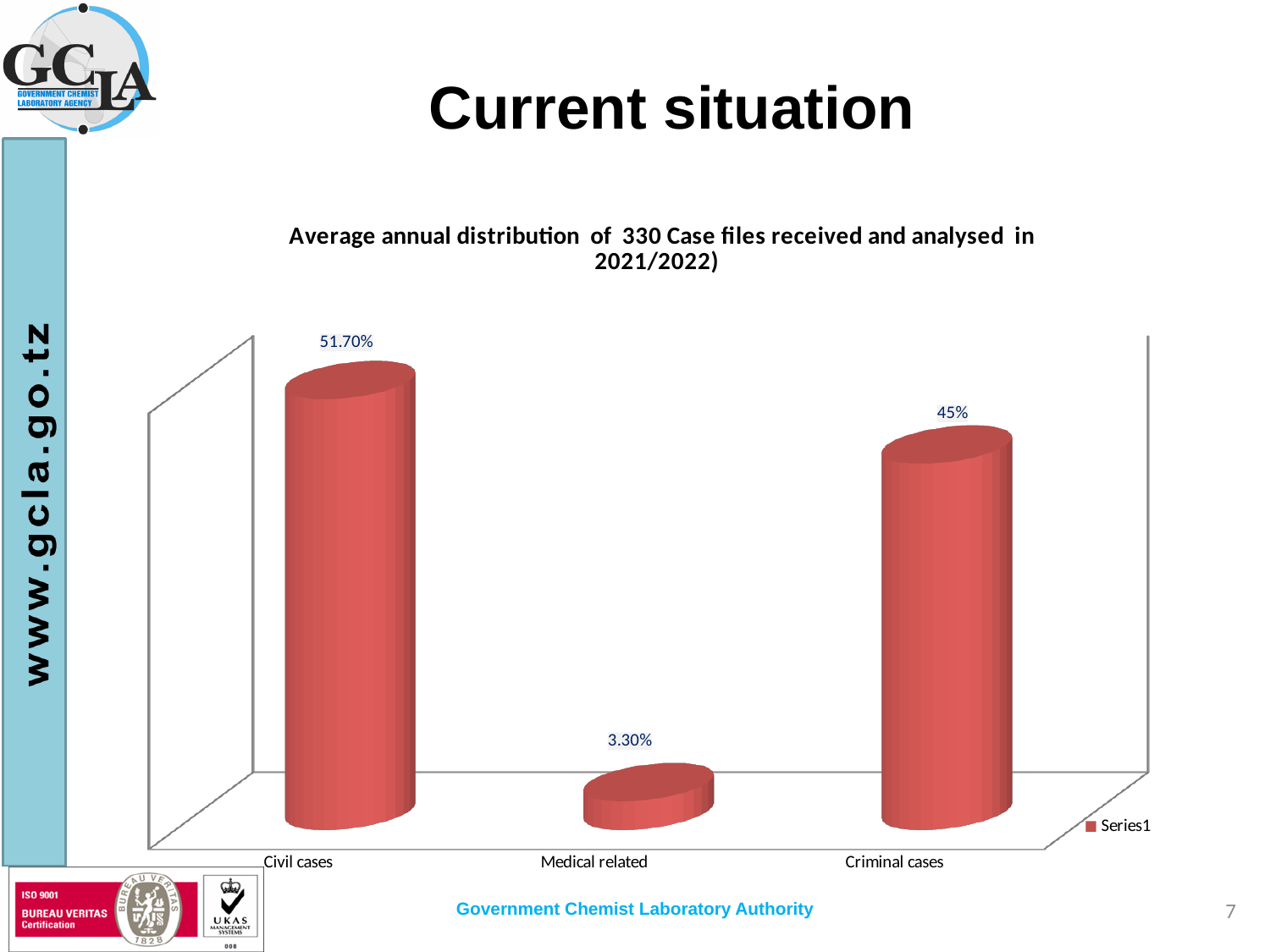
Which category has the highest value? Civil cases How many series does the legend list? 1 What is the value for Criminal cases? 45% Which category has the lowest value? Medical related What is the difference between the values for Criminal cases and Medical related? 41.70% What is the value for Civil cases? 51.70% What is the title of the chart? Average annual distribution of 330 Case files received and analysed in 2021/2022) What is the value for Medical related? 3.30% What kind of chart is shown on the slide? Bar chart What is the difference between the values for Civil cases and Criminal cases? 6.70% How many categories are shown on the chart? 3 Which is larger, the value for Civil cases or the value for Criminal cases? Civil cases